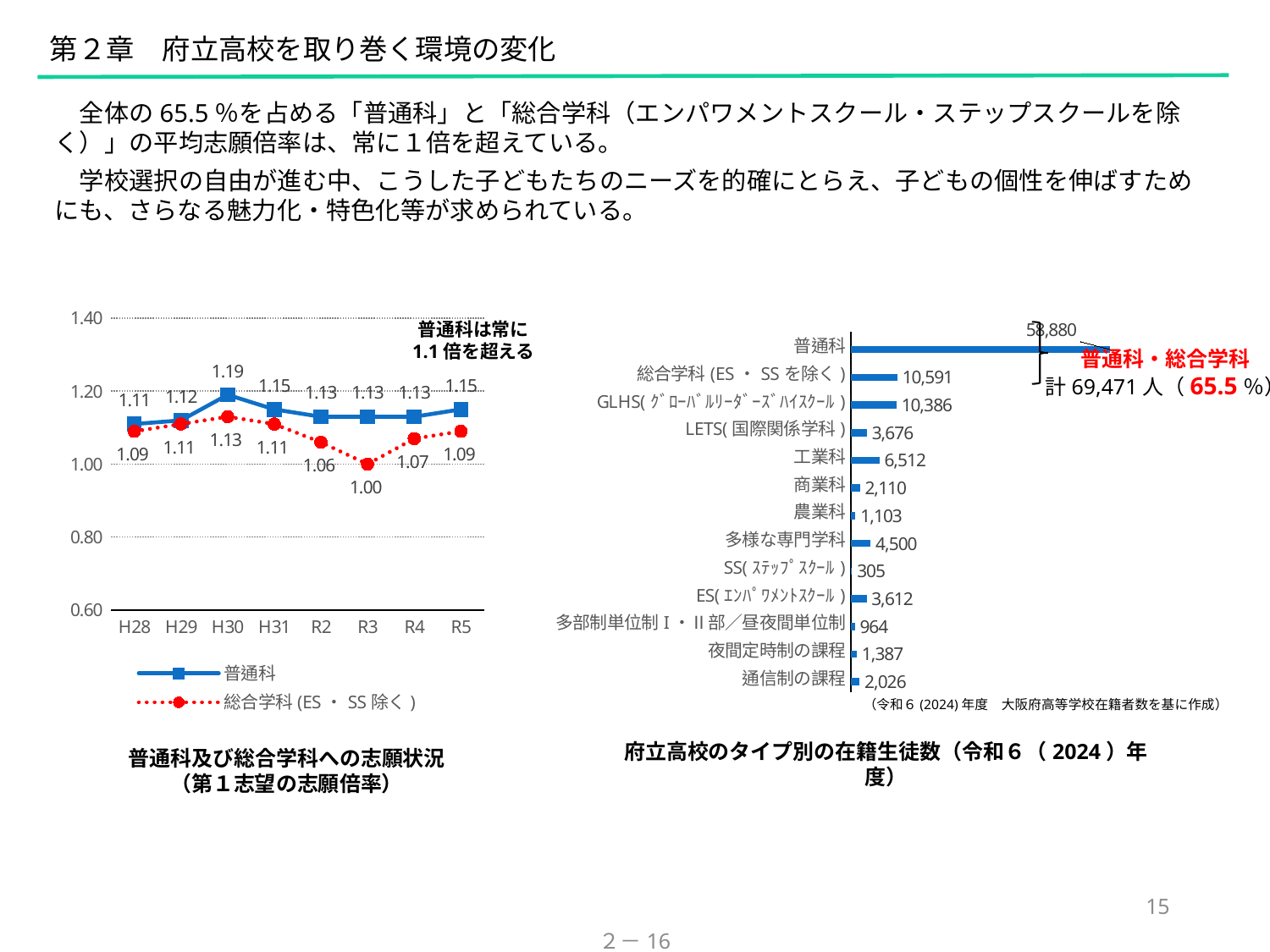
In the right chart (府立高校のタイプ別の在籍生徒数), which category has the lowest value? SS(ステップスクール) In the right chart (府立高校のタイプ別の在籍生徒数), which is larger, 総合学科 (ES・SSを除く) or GLHS? 総合学科 (ES・SSを除く) In the left chart (普通科及び総合学科への志願状況), in which year is the 総合学科 (ES・SS除く) value lowest? R3 What kind of chart is the right chart (府立高校のタイプ別の在籍生徒数)? bar chart In the left chart (普通科及び総合学科への志願状況), how many years are plotted on the x axis? 8 In the left chart (普通科及び総合学科への志願状況), does the 総合学科 (ES・SS除く) value rise or fall from H31 to R3? fall In the right chart (府立高校のタイプ別の在籍生徒数), what is the difference between 多様な専門学科 and ES(エンパワメントスクール)? 888 In the left chart (普通科及び総合学科への志願状況), what is the value for 総合学科 (ES・SS除く) at R3? 1.00 In the left chart (普通科及び総合学科への志願状況), what is the difference between 普通科 and 総合学科 (ES・SS除く) at R3? 0.13 In the left chart (普通科及び総合学科への志願状況), what is the value for 普通科 at H30? 1.19 In the right chart (府立高校のタイプ別の在籍生徒数), what is the value for 工業科? 6,512 In the left chart (普通科及び総合学科への志願状況), how many series does the legend list? 2